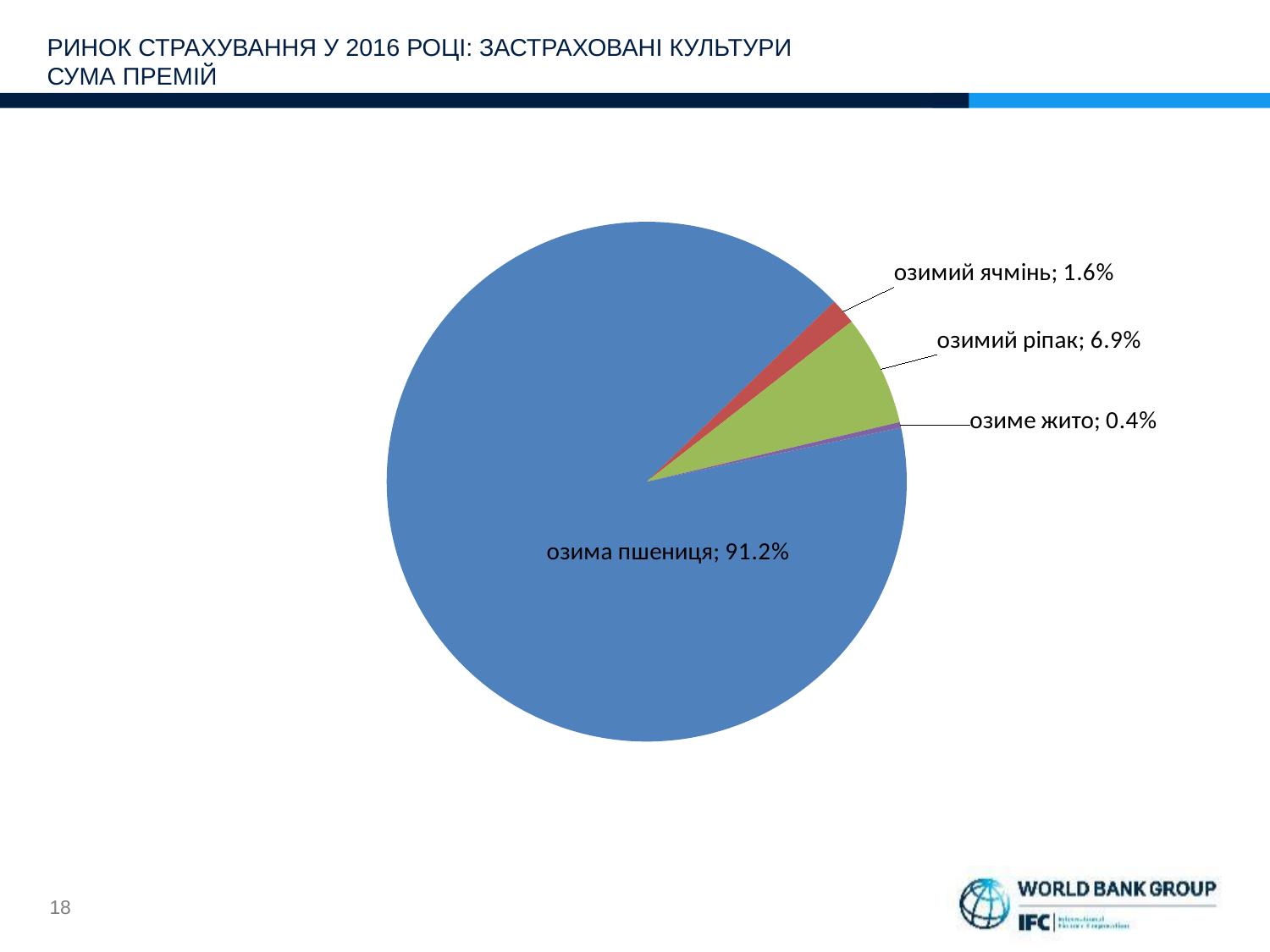
What share of the pie does озимий ріпак have? 6.9% How many categories are shown in the pie chart? 4 What colour is the slice for озимий ріпак? green What share of the pie does озимий ячмінь have? 1.6% Which is larger, the share for озимий ячмінь or the share for озиме жито? озимий ячмінь Which category has the largest slice of the pie? озима пшениця What is the difference in percentage points between озима пшениця and озимий ріпак? 84.3 What share of the pie does озима пшениця have? 91.2% What is the difference in percentage points between озимий ріпак and озимий ячмінь? 5.3 What kind of chart is shown on the slide? pie chart Which category has the smallest slice of the pie? озиме жито